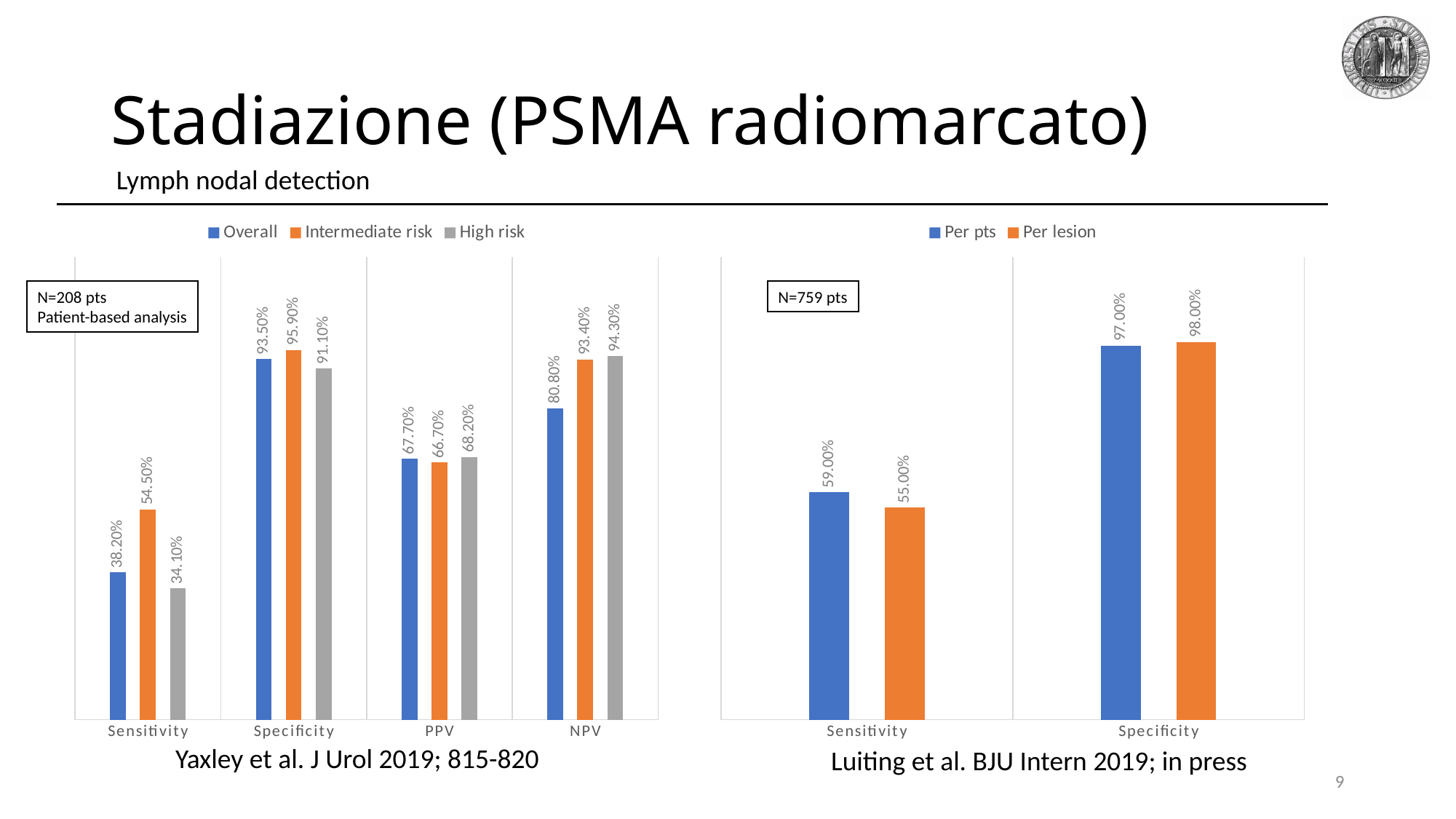
In the left chart (Yaxley et al.), how many categories are shown on the x axis? 4 In the right chart (Luiting et al.), which is larger for Specificity: Per pts or Per lesion? Per lesion In the left chart (Yaxley et al.), what is the difference between the Intermediate risk and Overall values for NPV? 12.60% In the left chart (Yaxley et al.), how many series does the legend list? 3 In the left chart (Yaxley et al.), which category has the lowest Overall value? Sensitivity In the right chart (Luiting et al.), what is the difference between the Per pts and Per lesion values for Sensitivity? 4.00% In the left chart (Yaxley et al.), what is the Overall value for Sensitivity? 38.20% What type of chart is the right chart (Luiting et al.)? Bar chart In the right chart (Luiting et al.), what is the Per lesion value for Sensitivity? 55.00% In the left chart (Yaxley et al.), what is the High risk value for NPV? 94.30% In the left chart (Yaxley et al.), which series has the highest value for Sensitivity? Intermediate risk In the left chart (Yaxley et al.), what is the Intermediate risk value for Specificity? 95.90%